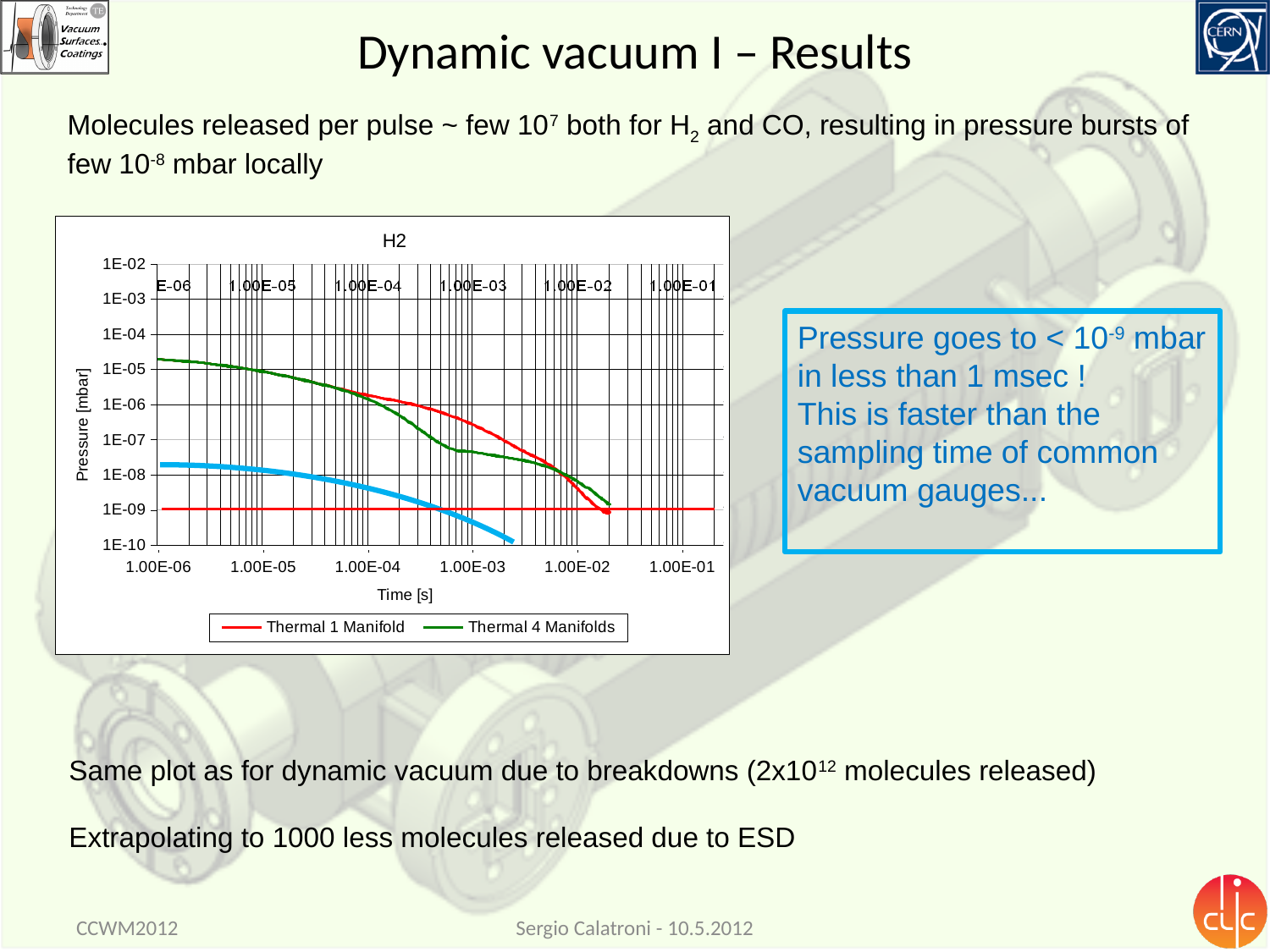
At a time of 1.00E-04 s, is the Thermal 4 Manifolds value greater or less than 1E-05 mbar? less What is the lowest value shown on the y axis of the chart? 1E-10 What is the title of the chart? H2 What is the label of the y axis of the chart? Pressure [mbar] What is the label of the x axis of the chart? Time [s] How many series does the chart legend list? 2 At a time of 1.00E-03 s, which series has the higher pressure, Thermal 1 Manifold or Thermal 4 Manifolds? Thermal 1 Manifold At a time of 1.00E-02 s, is the Thermal 1 Manifold value greater or less than 1E-07 mbar? less What are the two series named in the chart legend? Thermal 1 Manifold and Thermal 4 Manifolds What is the highest value shown on the x axis of the chart? 1.00E-01 What kind of chart is shown on the slide? Line chart Do the Thermal 1 Manifold and Thermal 4 Manifolds curves rise or fall as time increases? Fall